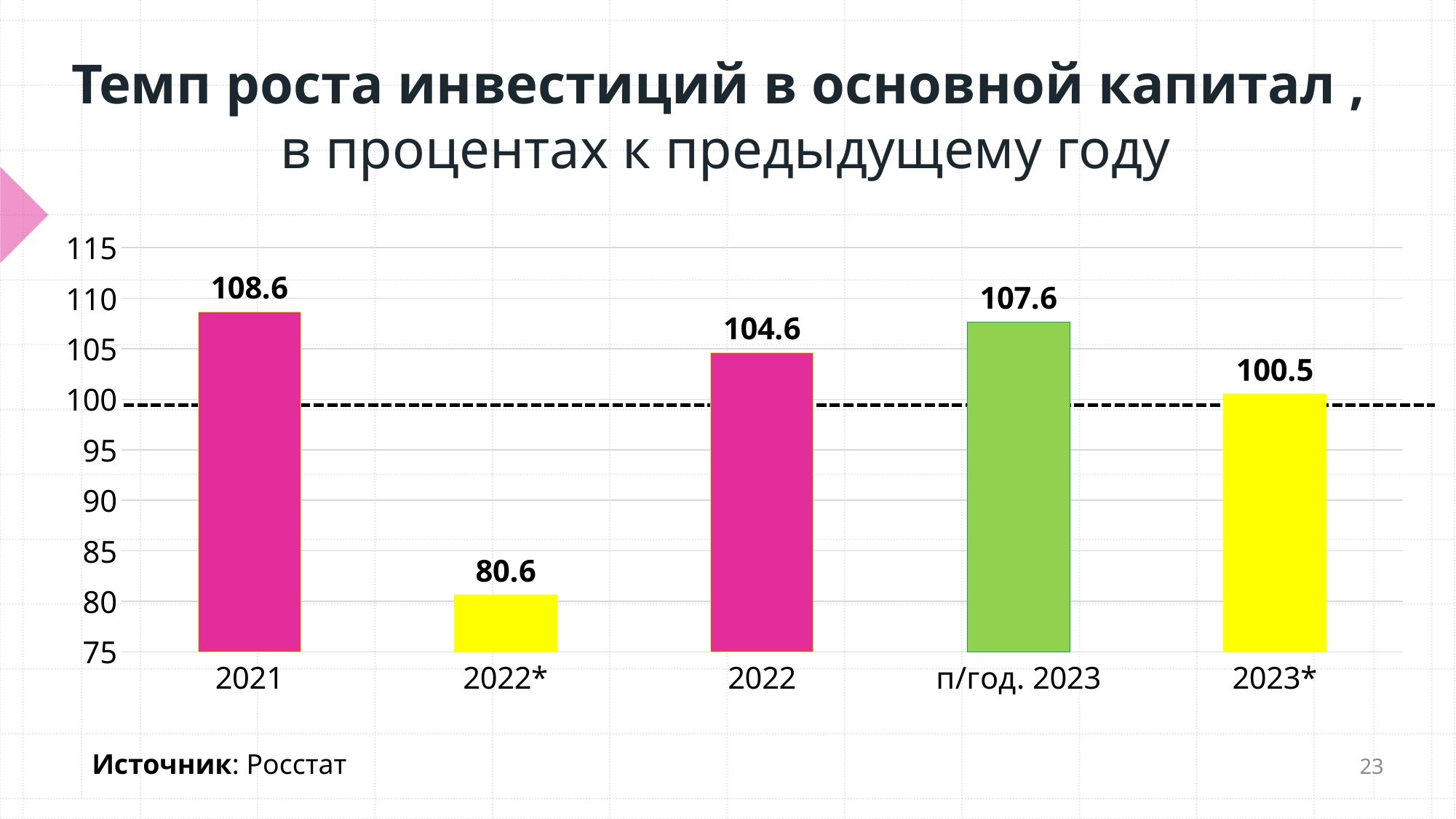
Which is larger, the value for 2022 or the value for п/год. 2023? п/год. 2023 Which category has the lowest value? 2022* What kind of chart is shown on the slide? bar chart What is the difference between the values for п/год. 2023 and 2023*? 7.1 What is the difference between the values for 2021 and 2022? 4 What is the value for 2022*? 80.6 What is the value for 2023*? 100.5 What is the value for 2021? 108.6 What is the value for п/год. 2023? 107.6 What source is cited for the chart data? Росстат How many bars are shown in the chart? 5 Which category has the highest value? 2021